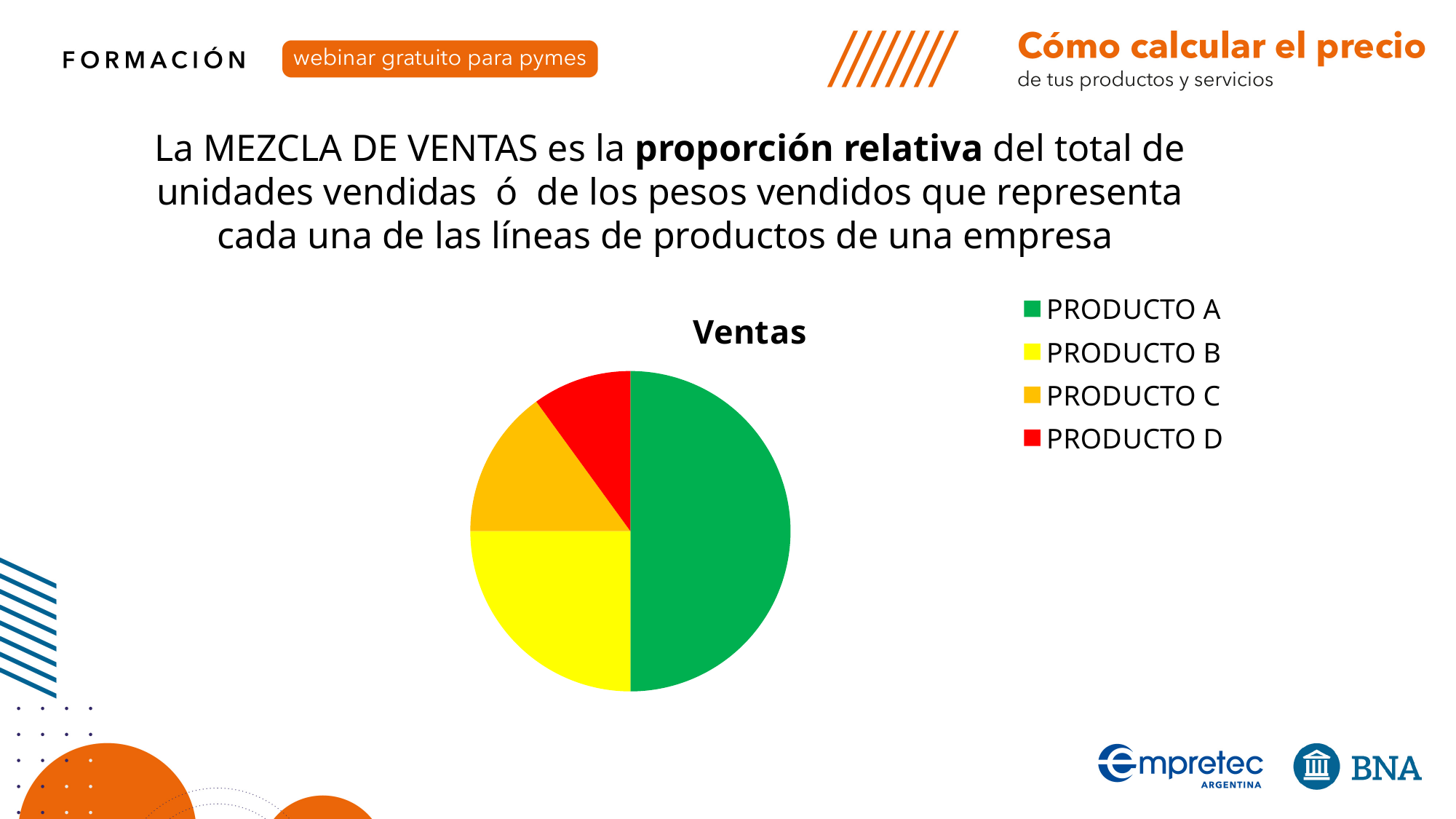
Which slice is larger, PRODUCTO A or PRODUCTO B? PRODUCTO A Which slice is larger, PRODUCTO C or PRODUCTO D? PRODUCTO C Which product has the smallest slice of the pie? PRODUCTO D Which product has the largest slice of the pie? PRODUCTO A Which slice is larger, PRODUCTO B or PRODUCTO D? PRODUCTO B How many entries does the chart legend list? 4 What kind of chart is shown on the slide? pie chart What is the title of the chart? Ventas How many slices does the pie chart have? 4 What colour represents PRODUCTO B in the pie chart? yellow